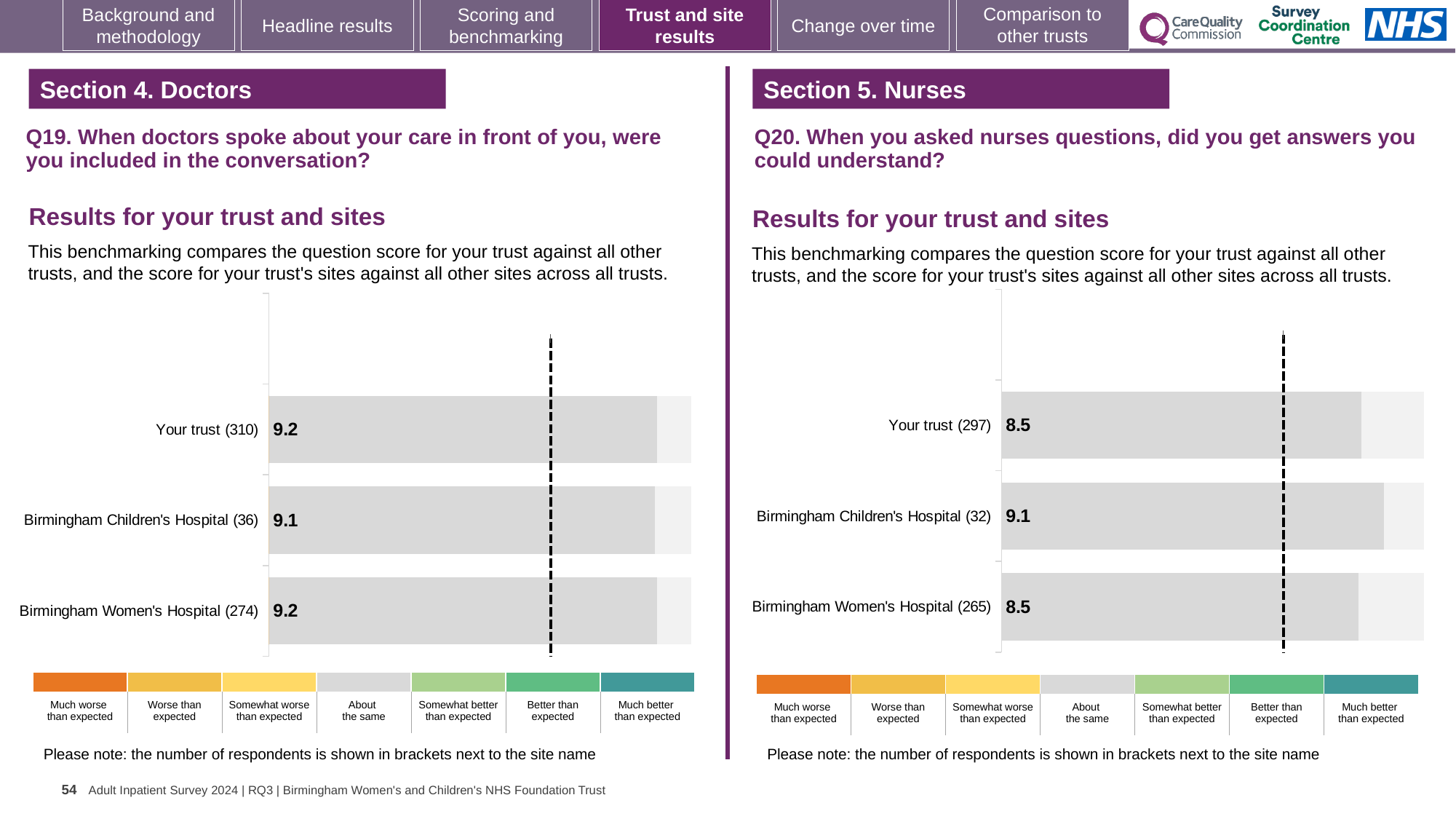
In the Q20 chart on the right, which has the larger score, Your trust or Birmingham Children's Hospital? Birmingham Children's Hospital In the Q20 chart on the right, what is the difference between the scores for Birmingham Children's Hospital and Birmingham Women's Hospital? 0.6 In the Q19 chart on the left, what is the score for Birmingham Women's Hospital? 9.2 In the Q19 chart on the left, what is the score for Your trust? 9.2 In the Q19 chart on the left, how many bars are plotted? 3 What kind of chart is the Q20 chart on the right? Bar chart In the Q20 chart on the right, what is the score for Birmingham Children's Hospital? 9.1 In the Q19 chart on the left, how many respondents are shown in brackets for Your trust? 310 In the Q20 chart on the right, how many respondents are shown in brackets for Birmingham Women's Hospital? 265 In the Q19 chart on the left, what is the score for Birmingham Children's Hospital? 9.1 In the Q20 chart on the right, what is the score for Your trust? 8.5 In the Q20 chart on the right, which site or trust has the highest score? Birmingham Children's Hospital